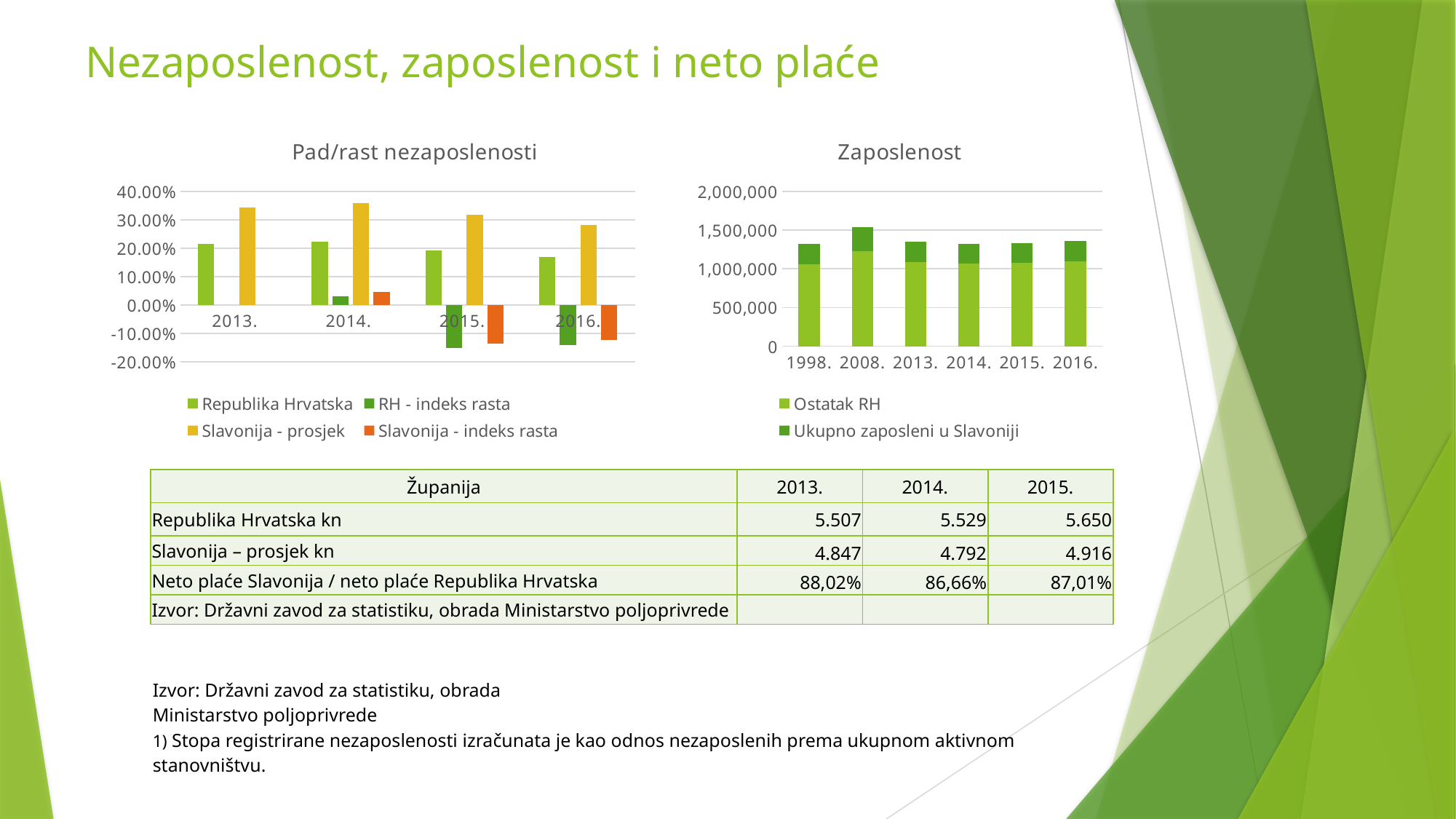
In the 'Zaposlenost' chart, which year has the tallest stacked bar? 2008. In the 'Pad/rast nezaposlenosti' chart, do the Republika Hrvatska values rise or fall from 2014. to 2016.? fall How many series does the legend of the 'Pad/rast nezaposlenosti' chart list? 4 How many years are shown on the x axis of the 'Pad/rast nezaposlenosti' chart? 4 What kind of chart is the 'Zaposlenost' chart? stacked bar chart In the 'Pad/rast nezaposlenosti' chart, which is larger in 2013.: Republika Hrvatska or Slavonija - prosjek? Slavonija - prosjek How many series does the legend of the 'Zaposlenost' chart list? 2 In the 'Pad/rast nezaposlenosti' chart, in which year is the Slavonija - prosjek bar highest? 2014. What kind of chart is the 'Pad/rast nezaposlenosti' chart? bar chart In the 'Zaposlenost' chart, is the value for Ostatak RH in 2008. greater or less than 1,000,000? greater In the 'Pad/rast nezaposlenosti' chart, is the value for Slavonija - prosjek in 2014. greater or less than 30.00%? greater In the 'Pad/rast nezaposlenosti' chart, is the value for Republika Hrvatska in 2016. greater or less than 20.00%? less